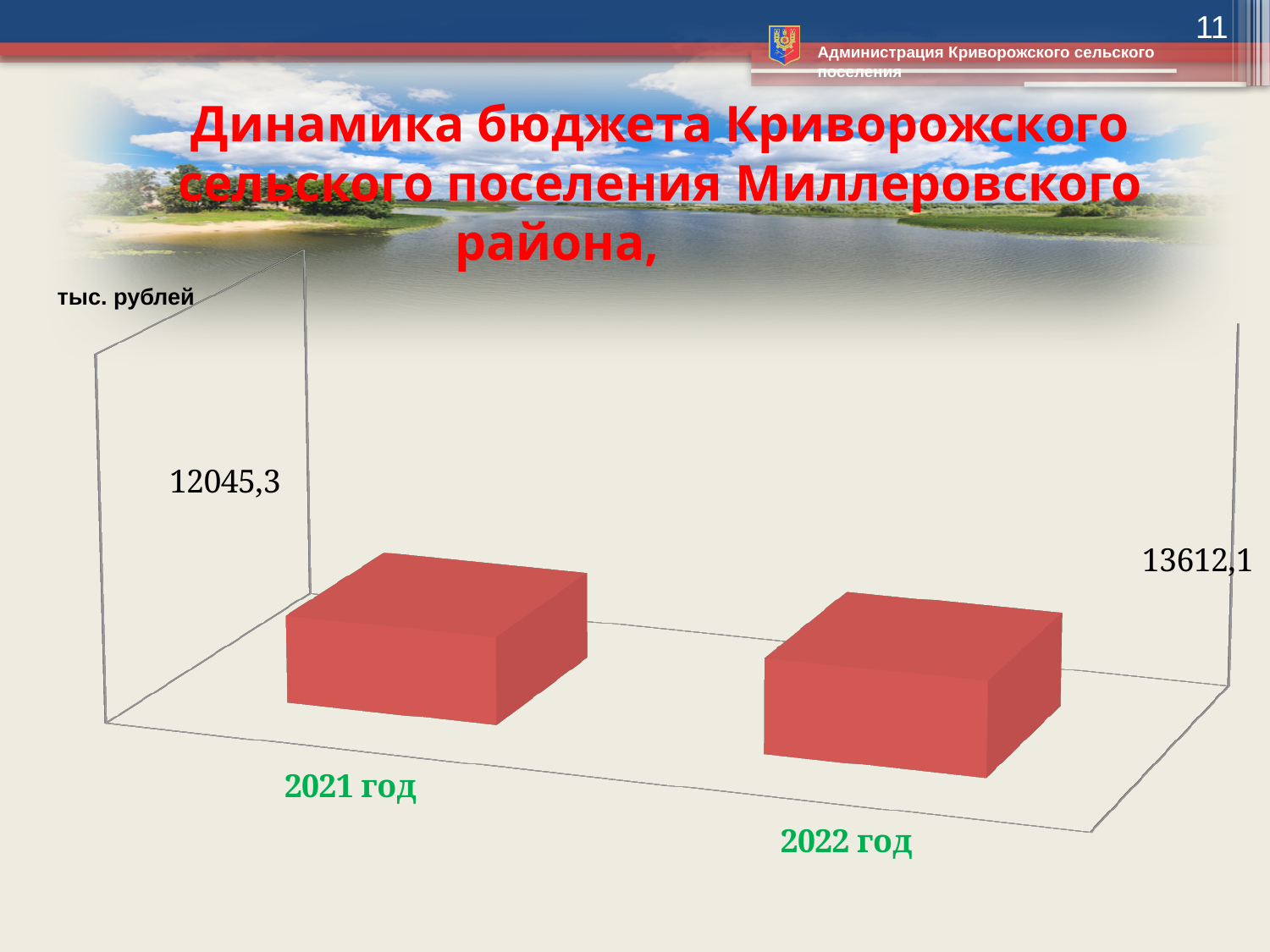
What is the difference between the 2022 год and 2021 год values? 1566,8 What is the budget value shown for 2022 год? 13612,1 Do the values rise or fall from 2021 год to 2022 год? rise What is the budget value shown for 2021 год? 12045,3 What type of chart is shown on the slide? bar chart Which year has the lower budget value? 2021 год Which year has the higher budget value? 2022 год How many years (categories) are shown in the chart? 2 What unit of measurement is indicated for the chart values? тыс. рублей What colour are the bars in the chart? red Is the value for 2022 год larger or smaller than the value for 2021 год? larger